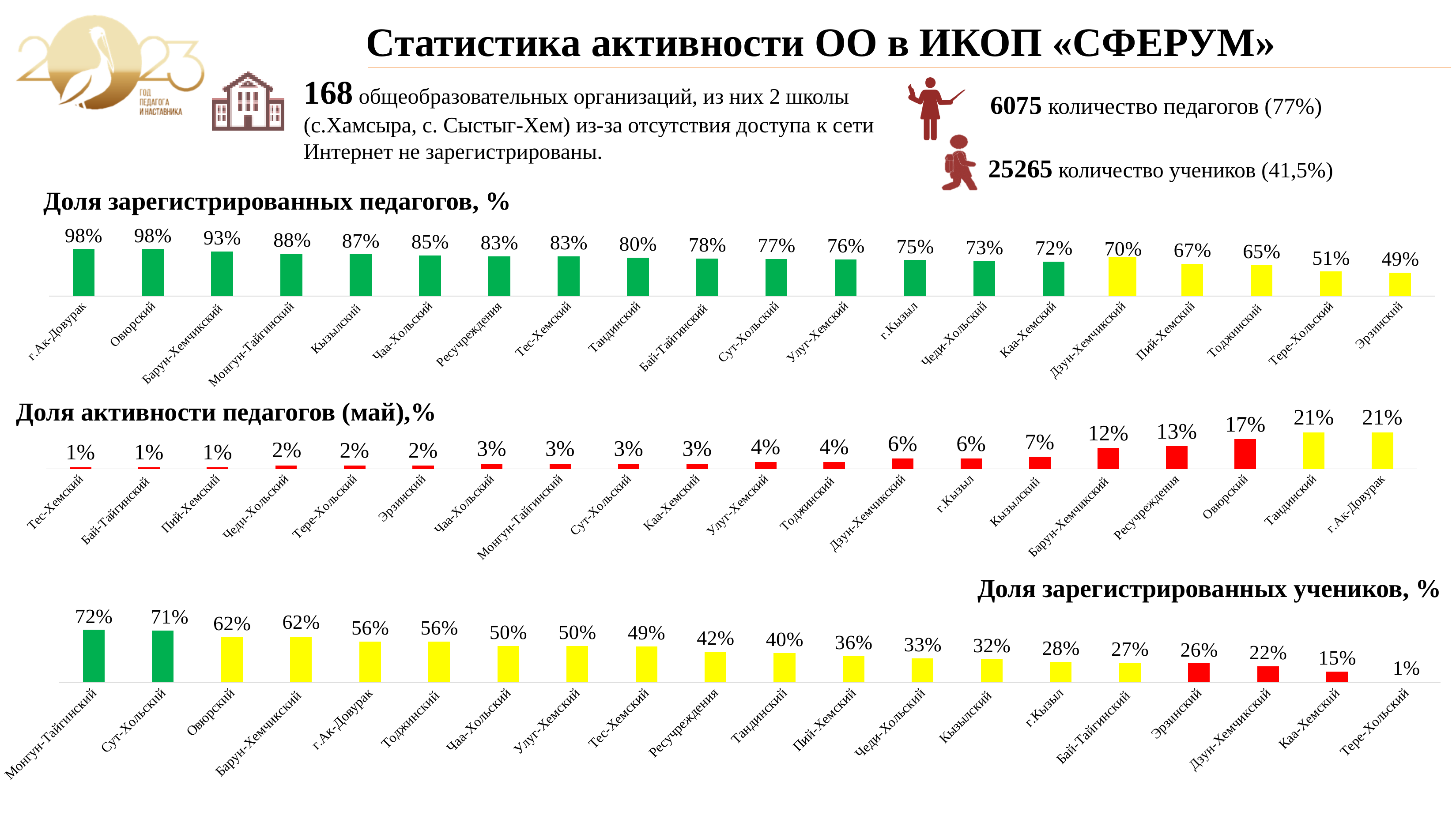
In the chart "Доля зарегистрированных учеников, %", what is the difference between Сут-Хольский and Каа-Хемский? 56% In the chart "Доля зарегистрированных педагогов, %", what is the value for Кызылский? 87% In the chart "Доля зарегистрированных педагогов, %", how many categories are shown? 20 In the chart "Доля зарегистрированных учеников, %", which category has the highest value? Монгун-Тайгинский In the chart "Доля активности педагогов (май),%", which is larger, Ресучреждения or Кызылский? Ресучреждения In the chart "Доля зарегистрированных педагогов, %", which category has the lowest value? Эрзинский What kind of chart is "Доля активности педагогов (май),%"? bar chart In the chart "Доля зарегистрированных педагогов, %", what is the difference between Барун-Хемчикский and Тоджинский? 28% In the chart "Доля активности педагогов (май),%", what is the value for Овюрский? 17% In the chart "Доля зарегистрированных учеников, %", what is the value for Тандинский? 40% In the chart "Доля активности педагогов (май),%", do the values rise or fall from left to right? rise In the chart "Доля зарегистрированных учеников, %", what colour are the bars for Монгун-Тайгинский and Сут-Хольский? green